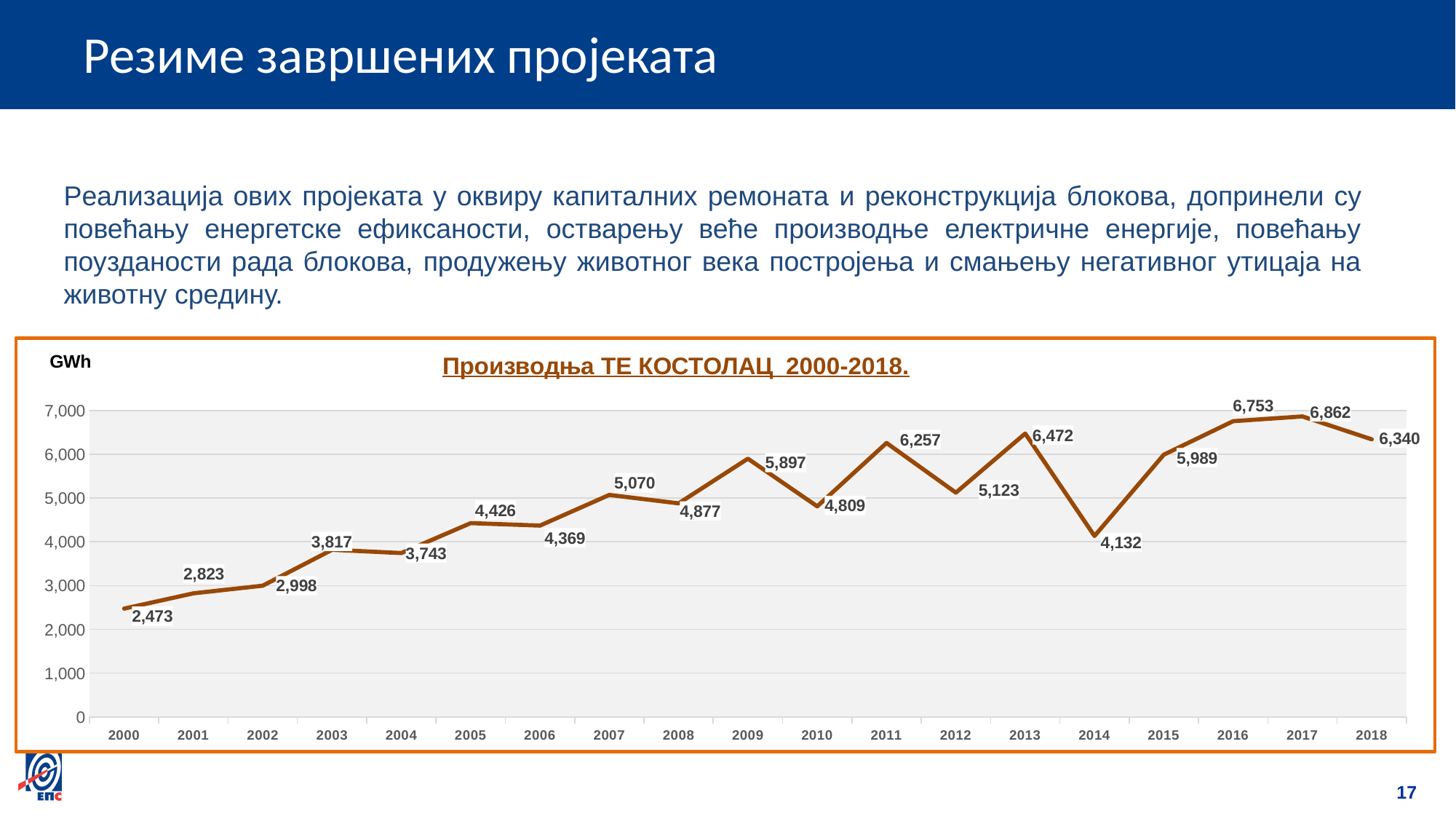
What type of chart is shown on the slide? Line chart How many years (data points) are plotted on the chart? 19 What value is shown for 2014 on the chart? 4,132 What was the production in 2018? 6,340 What was the production of TE Kostolac in 2000? 2,473 Which year had higher production, 2009 or 2010? 2009 What unit is indicated for the values on the chart? GWh What is the difference between the 2018 value and the 2000 value? 3,867 What is the overall trend of production from 2000 to 2017? Rising Which year has the highest production value on the chart? 2017 Which year has the lowest production value on the chart? 2000 By how much did production fall from 2013 to 2014? 2,340